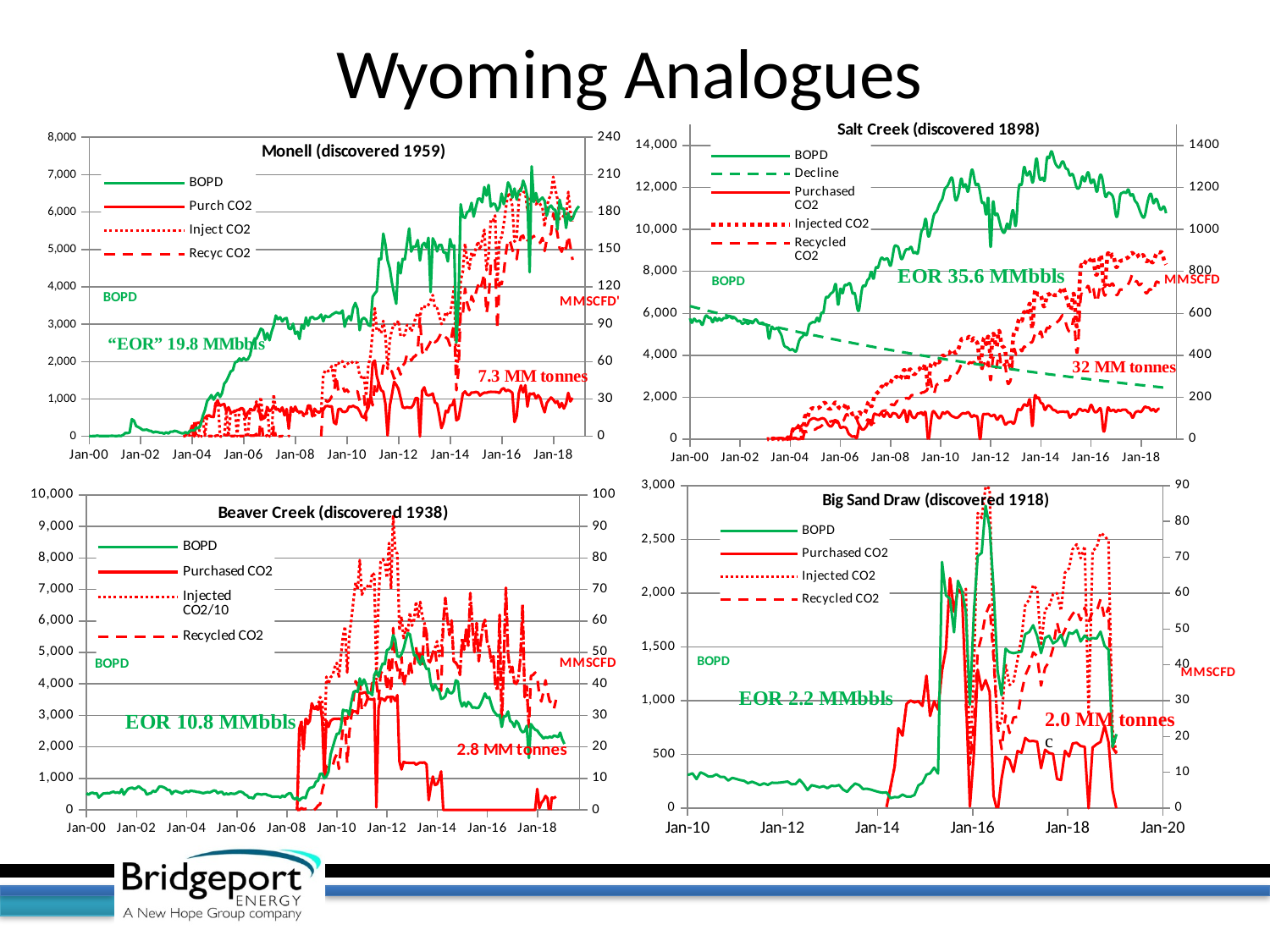
On the Salt Creek (discovered 1898) chart, what EOR volume is annotated? 35.6 MMbbls On the Big Sand Draw (discovered 1918) chart, what EOR volume is annotated? 2.2 MMbbls On the Beaver Creek (discovered 1938) chart, is the BOPD value at Jan-00 greater or less than 1,000? less On the Monell (discovered 1959) chart, how many MM tonnes are annotated? 7.3 MM tonnes How many series does the legend of the Salt Creek (discovered 1898) chart list? 5 Which chart on the slide shows the field with the earliest discovery year? Salt Creek (discovered 1898) On the Beaver Creek (discovered 1938) chart, how many MM tonnes are annotated? 2.8 MM tonnes On the Salt Creek (discovered 1898) chart, is the peak BOPD value around Jan-14 greater or less than 12,000? greater On the Salt Creek (discovered 1898) chart, does the Decline series rise or fall from Jan-00 to Jan-18? fall How many series does the legend of the Beaver Creek (discovered 1938) chart list? 4 What is the label on the right-hand axis of the Big Sand Draw (discovered 1918) chart? MMSCFD What kind of chart is the Monell (discovered 1959) chart? line chart